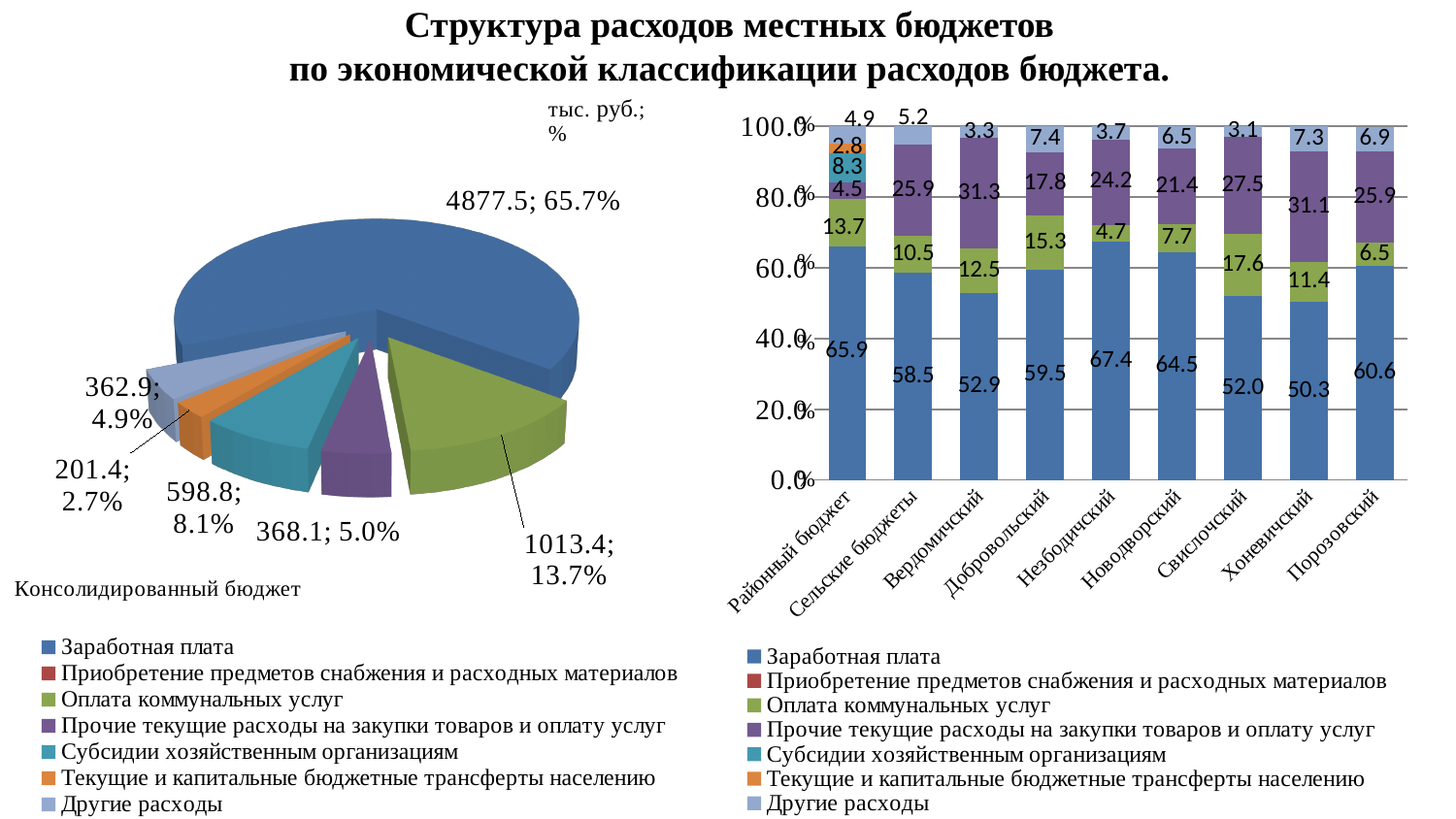
In the stacked bar chart on the right, how many categories are shown on the x axis? 9 In the stacked bar chart on the right, what is the value of Заработная плата for Незбодичский? 67.4 In the stacked bar chart on the right, what is the value of Оплата коммунальных услуг for Свислочский? 17.6 In the stacked bar chart on the right, which category has the lowest value for Заработная плата? Хоневичский How many series does the legend of the stacked bar chart on the right list? 7 In the pie chart on the left, what share does the slice labelled 1013.4 have? 13.7% In the pie chart on the left (Консолидированный бюджет), what value is shown for the largest slice? 4877.5; 65.7% In the pie chart on the left, which is larger: the slice with 598.8 or the slice with 368.1? 598.8 In the stacked bar chart on the right, what is the difference between the Заработная плата values for Районный бюджет and Сельские бюджеты? 7.4 In the pie chart on the left, what is the value of the slice with a 2.7% share? 201.4 What type of chart is shown on the right side of the slide? Stacked bar chart In the stacked bar chart on the right, which category has the highest value for Заработная плата? Незбодичский